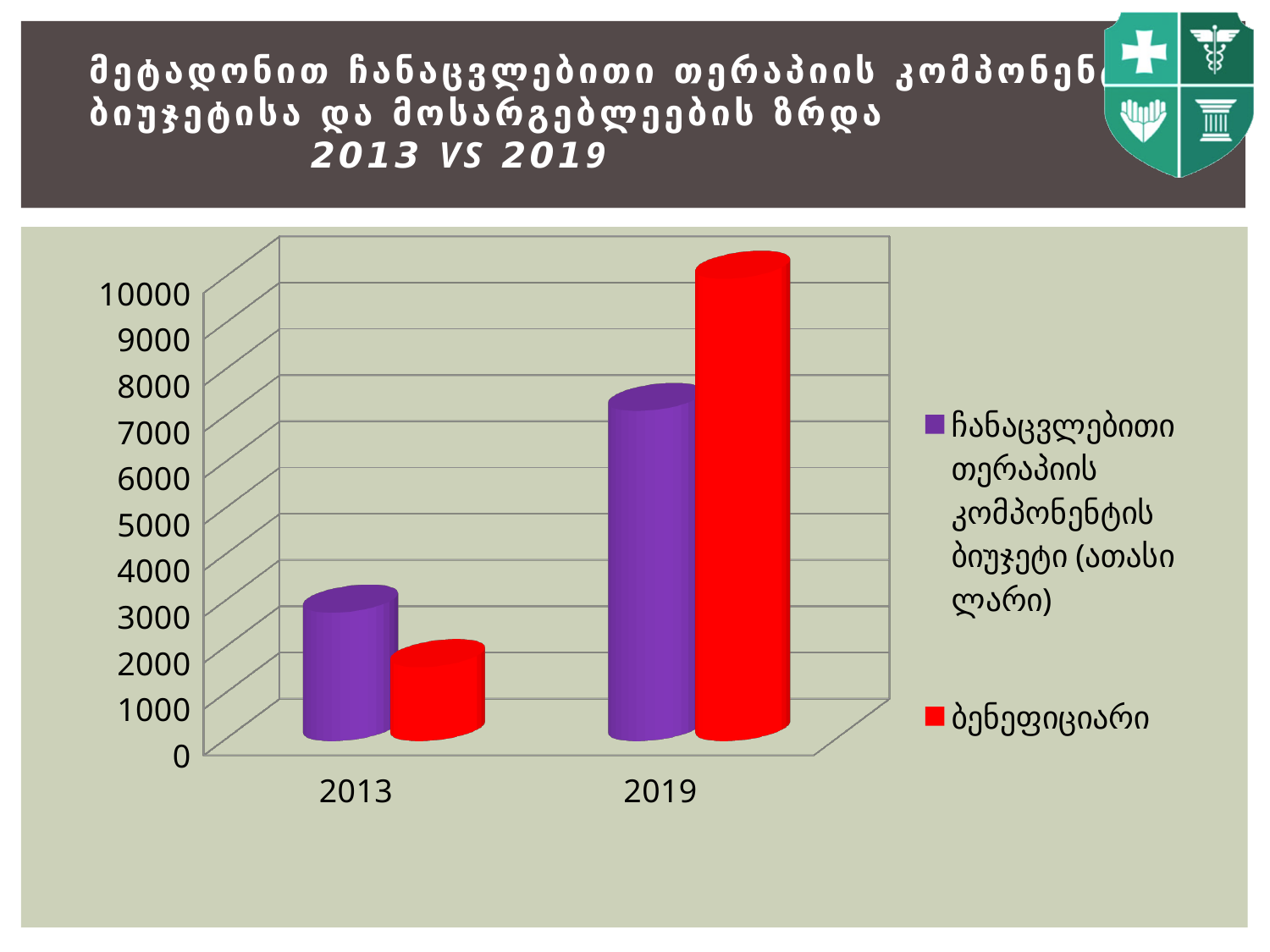
Which category has the highest bar for ბენეფიციარი? 2019 How many series does the chart legend list? 2 Is the value for ჩანაცვლებითი თერაპიის კომპონენტის ბიუჯეტი (ათასი ლარი) in 2019 greater or less than 6000? greater In 2013, which series has the larger value: ჩანაცვლებითი თერაპიის კომპონენტის ბიუჯეტი (ათასი ლარი) or ბენეფიციარი? ჩანაცვლებითი თერაპიის კომპონენტის ბიუჯეტი (ათასი ლარი) What kind of chart is shown on the slide? bar chart Does the value for ბენეფიციარი rise or fall from 2013 to 2019? rise How many categories are shown on the x axis of the chart? 2 In 2019, which series has the larger value: ჩანაცვლებითი თერაპიის კომპონენტის ბიუჯეტი (ათასი ლარი) or ბენეფიციარი? ბენეფიციარი Is the value for ბენეფიციარი in 2013 greater or less than 3000? less Which category has the lowest bar for ბენეფიციარი? 2013 What colour represents ბენეფიციარი in the chart? red Is the value for ბენეფიციარი in 2019 greater or less than 9000? greater